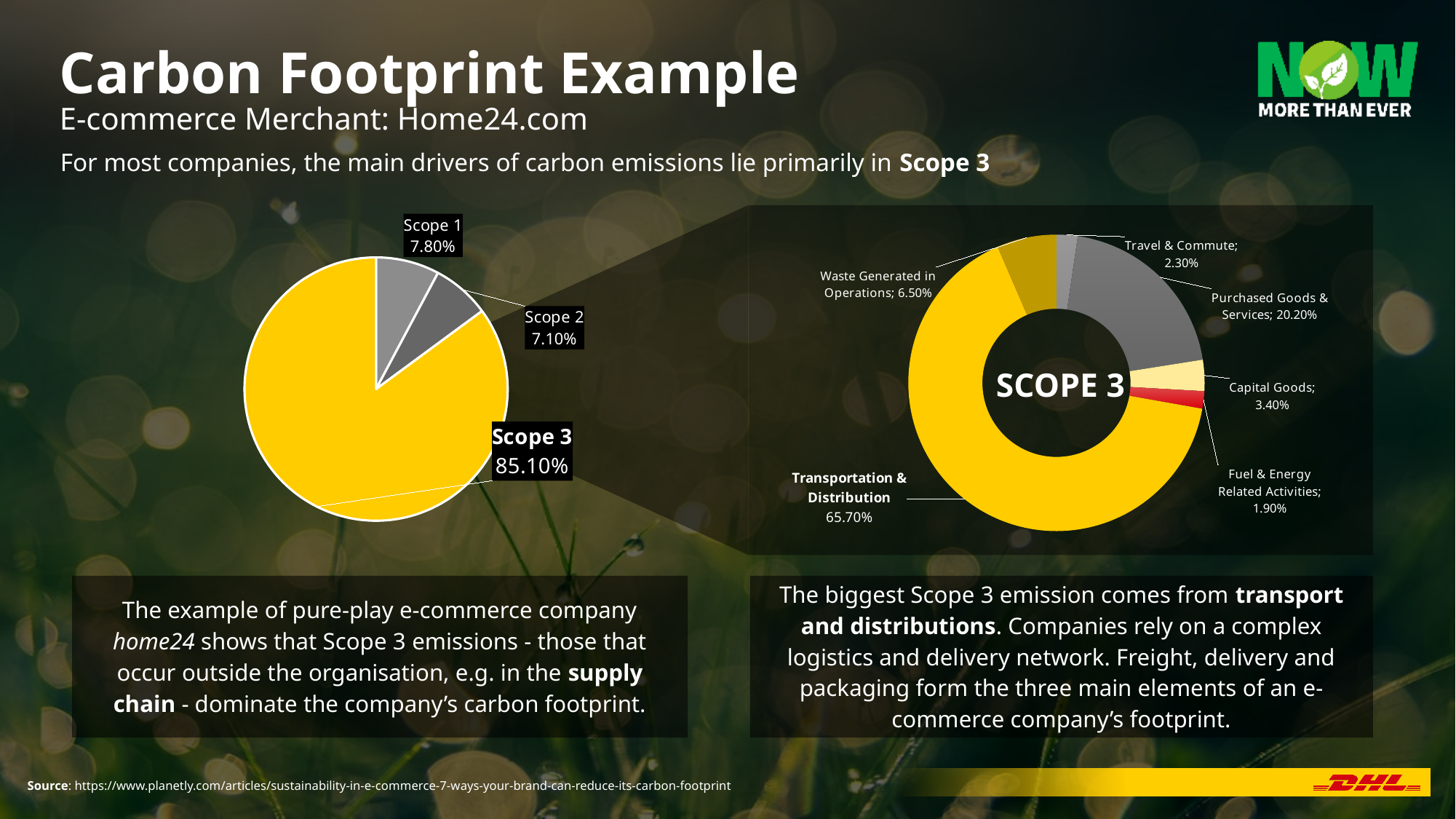
In the right Scope 3 doughnut chart, which category has the largest share? Transportation & Distribution How many slices does the left pie chart have? 3 In the left pie chart, what share does Scope 3 account for? 85.10% In the right Scope 3 doughnut chart, what is the difference between Transportation & Distribution and Purchased Goods & Services? 45.50% In the left pie chart, what is the difference between the Scope 1 and Scope 2 shares? 0.70% How many categories are shown in the right Scope 3 doughnut chart? 6 In the right Scope 3 doughnut chart, which is larger: Capital Goods or Travel & Commute? Capital Goods In the right Scope 3 doughnut chart, which category has the smallest share? Fuel & Energy Related Activities In the left pie chart, what is the value for Scope 1? 7.80% In the right Scope 3 doughnut chart, what is the value for Purchased Goods & Services? 20.20% In the right Scope 3 doughnut chart, what is the value for Waste Generated in Operations? 6.50% In the left pie chart, which scope has the smallest share? Scope 2